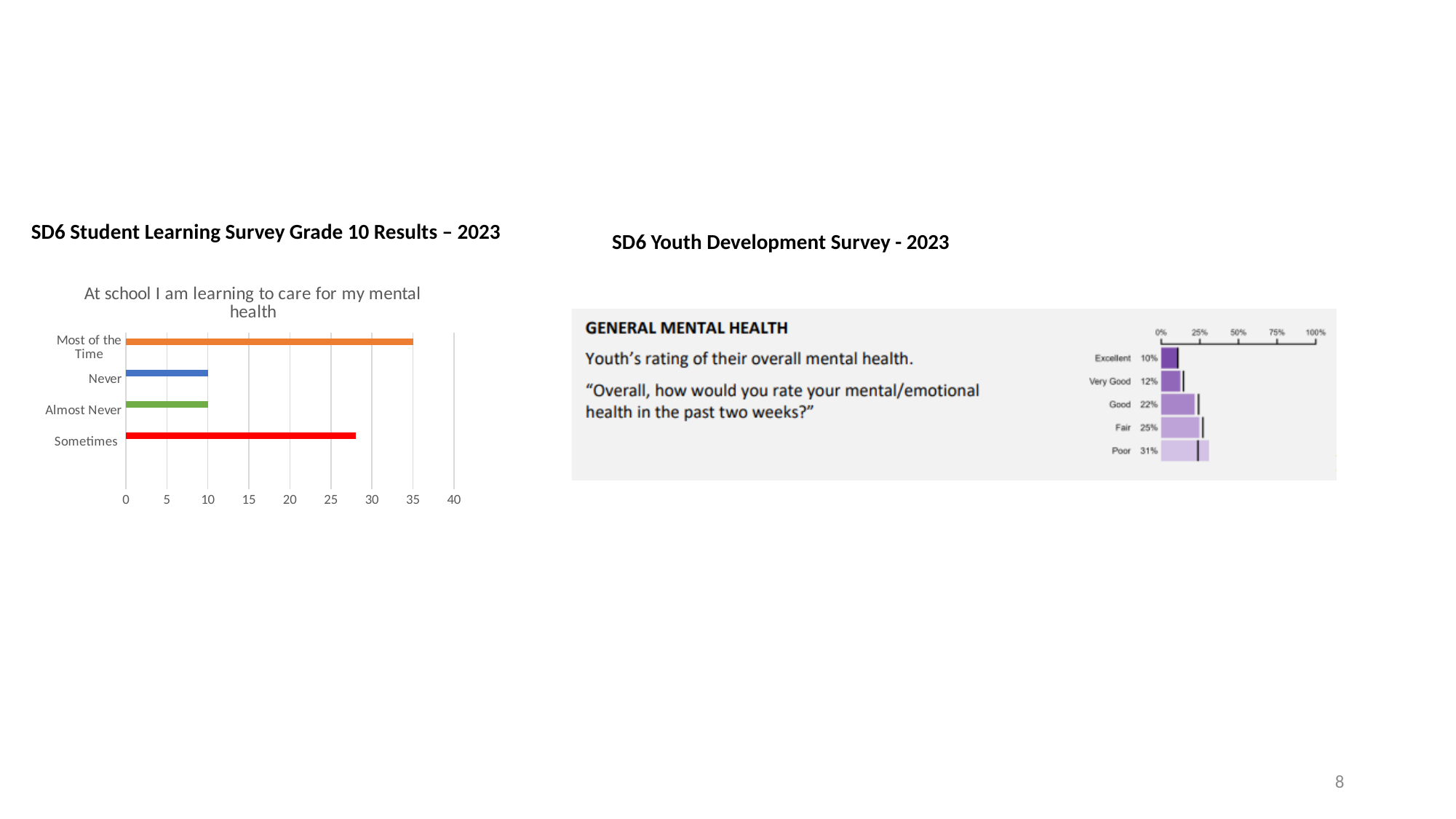
In the General Mental Health chart on the right, which is larger, Fair or Very Good? Fair In the chart titled "At school I am learning to care for my mental health", how many categories are shown? 4 In the chart titled "At school I am learning to care for my mental health", what is the value for Never? 10 In the General Mental Health chart on the right, what percentage of youth rated their mental health as Poor? 31% In the chart titled "At school I am learning to care for my mental health", is the value for Sometimes greater or less than 30? less In the General Mental Health chart on the right, what percentage of youth rated their mental health as Good? 22% In the General Mental Health chart on the right, which rating has the lowest percentage? Excellent What kind of chart is the one titled "At school I am learning to care for my mental health"? bar chart In the General Mental Health chart on the right, what is the difference between the Poor and Excellent percentages? 21% In the chart titled "At school I am learning to care for my mental health", which category has the highest value? Most of the Time In the chart titled "At school I am learning to care for my mental health", what is the value for Most of the Time? 35 In the chart titled "At school I am learning to care for my mental health", is the value for Sometimes greater or less than 25? greater